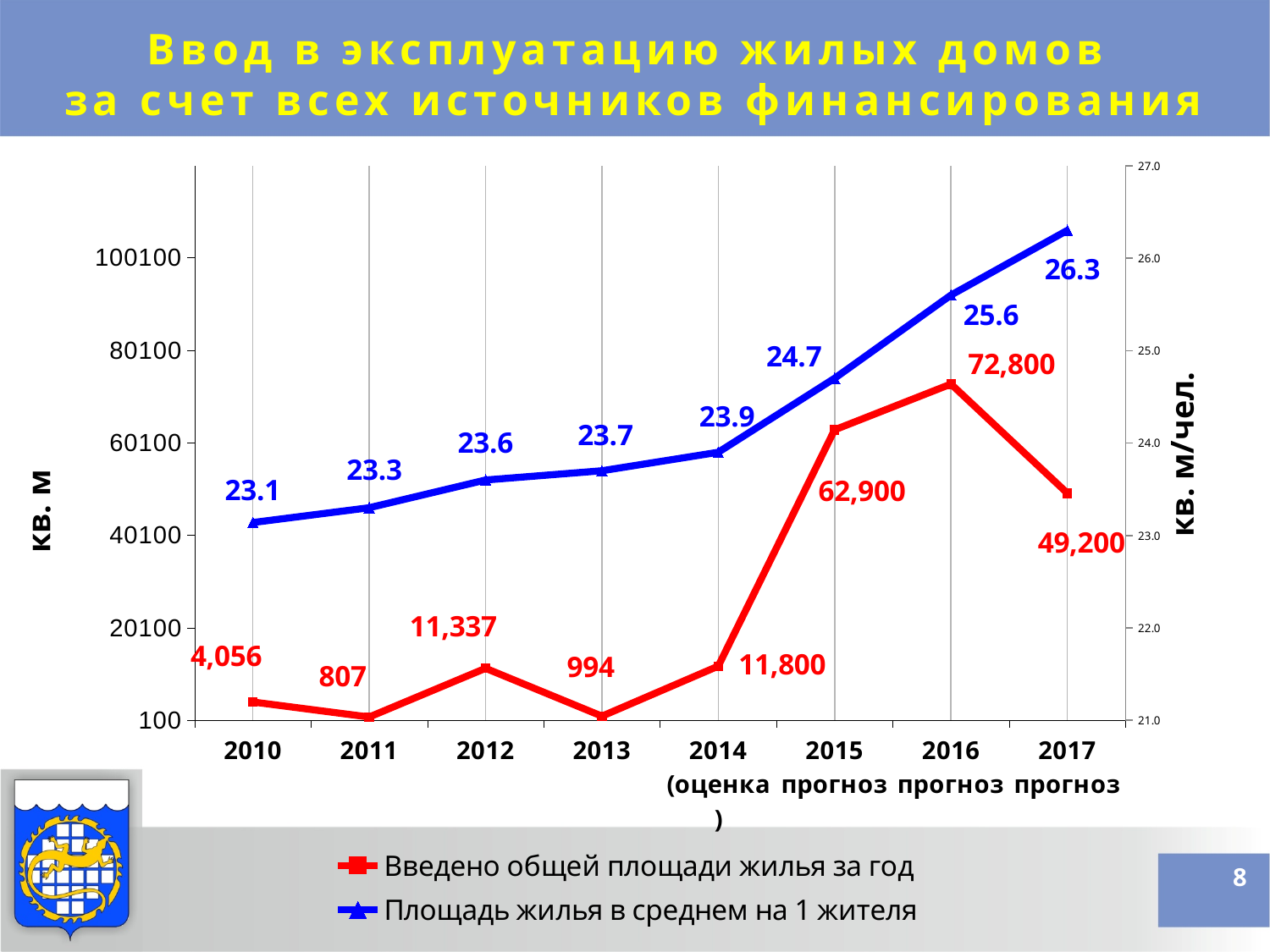
In which year is 'Введено общей площади жилья за год' lowest? 2011 Does 'Площадь жилья в среднем на 1 жителя' rise or fall from 2010 to 2017? rise How many years are shown on the x axis? 8 In which year is 'Площадь жилья в среднем на 1 жителя' highest? 2017 What is the value of 'Площадь жилья в среднем на 1 жителя' in 2013? 23.7 What is the value of 'Введено общей площади жилья за год' in 2016? 72,800 How many series does the legend list? 2 In which year is 'Введено общей площади жилья за год' highest? 2016 Which is larger for 'Введено общей площади жилья за год': 2012 or 2014? 2014 What type of chart is shown on the slide? line chart What is the difference between 'Введено общей площади жилья за год' in 2016 and 2017? 23,600 What is the value of 'Введено общей площади жилья за год' in 2011? 807